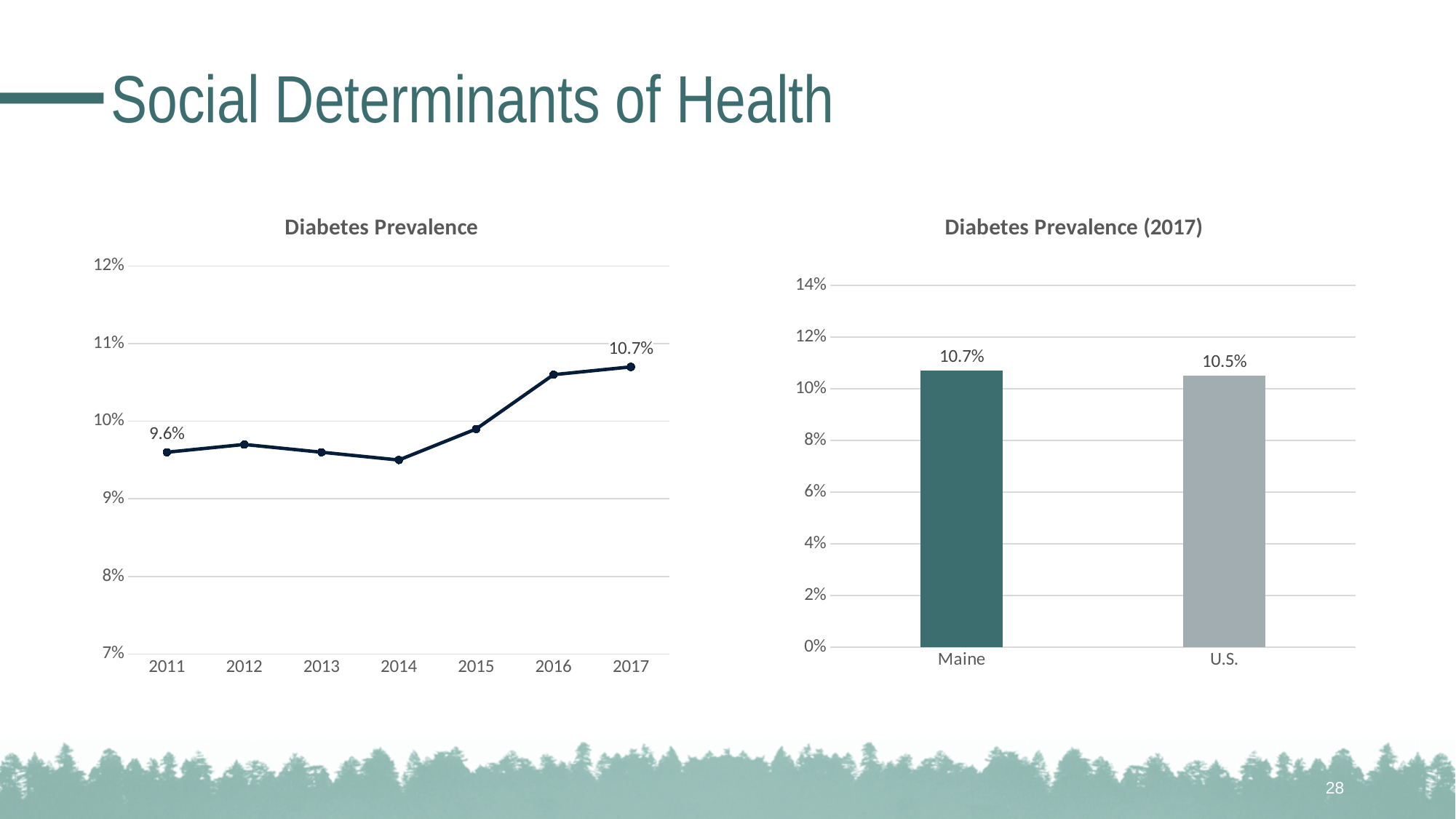
In the 'Diabetes Prevalence (2017)' chart, what is the difference between Maine and U.S.? 0.2% In the 'Diabetes Prevalence' line chart, what is the value for 2011? 9.6% In the 'Diabetes Prevalence' line chart, which year has the highest value? 2017 In the 'Diabetes Prevalence (2017)' chart, what is the value for U.S.? 10.5% In the 'Diabetes Prevalence' line chart, do values generally rise or fall from 2014 to 2017? rise In the 'Diabetes Prevalence' line chart, which year has the lowest value? 2014 In the 'Diabetes Prevalence' line chart, what is the value for 2017? 10.7% In the 'Diabetes Prevalence' line chart, what is the difference between the 2017 and 2011 values? 1.1% In the 'Diabetes Prevalence' line chart, is the value for 2016 greater or less than 10%? greater In the 'Diabetes Prevalence (2017)' chart, what is the value for Maine? 10.7% What kind of chart is the 'Diabetes Prevalence (2017)' chart? bar chart In the 'Diabetes Prevalence' line chart, how many years are plotted? 7